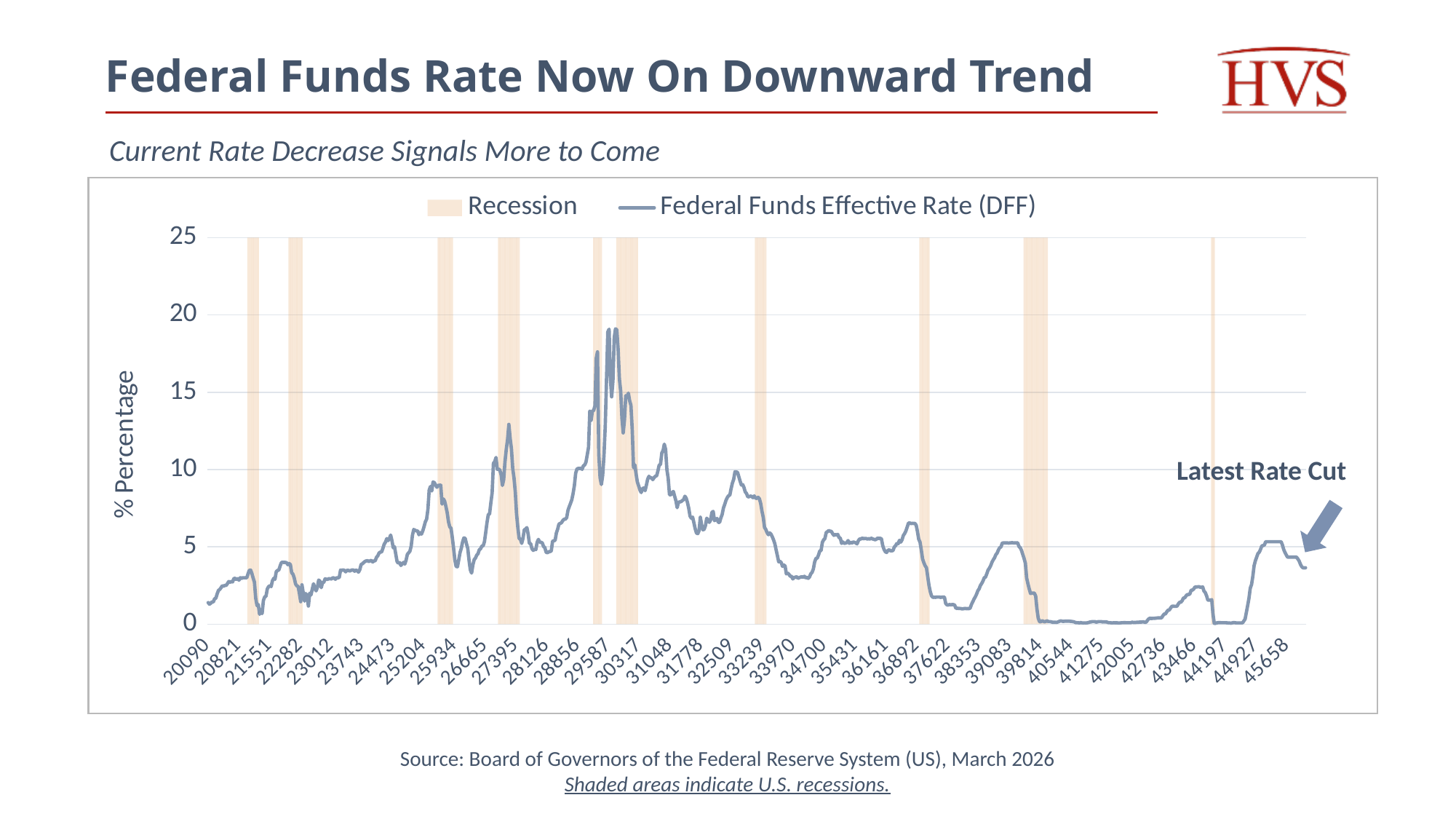
Is the Federal Funds Effective Rate at the start of the series (x label 20090) greater or less than 5? less Is the highest value reached by the Federal Funds Effective Rate line greater or less than 15? greater Is the Federal Funds Effective Rate around x label 41275 greater or less than 5? less What is the label of the y axis? % Percentage Near which x-axis label does the Federal Funds Effective Rate reach its highest peak? 29587 What is the highest value shown on the y axis? 25 What does the annotation with the arrow at the right end of the line say? Latest Rate Cut How many entries does the chart legend list? 2 Does the Federal Funds Effective Rate rise or fall over the last portion of the series, after the point marked 'Latest Rate Cut' is approached? fall What kind of chart is shown on the slide? line chart